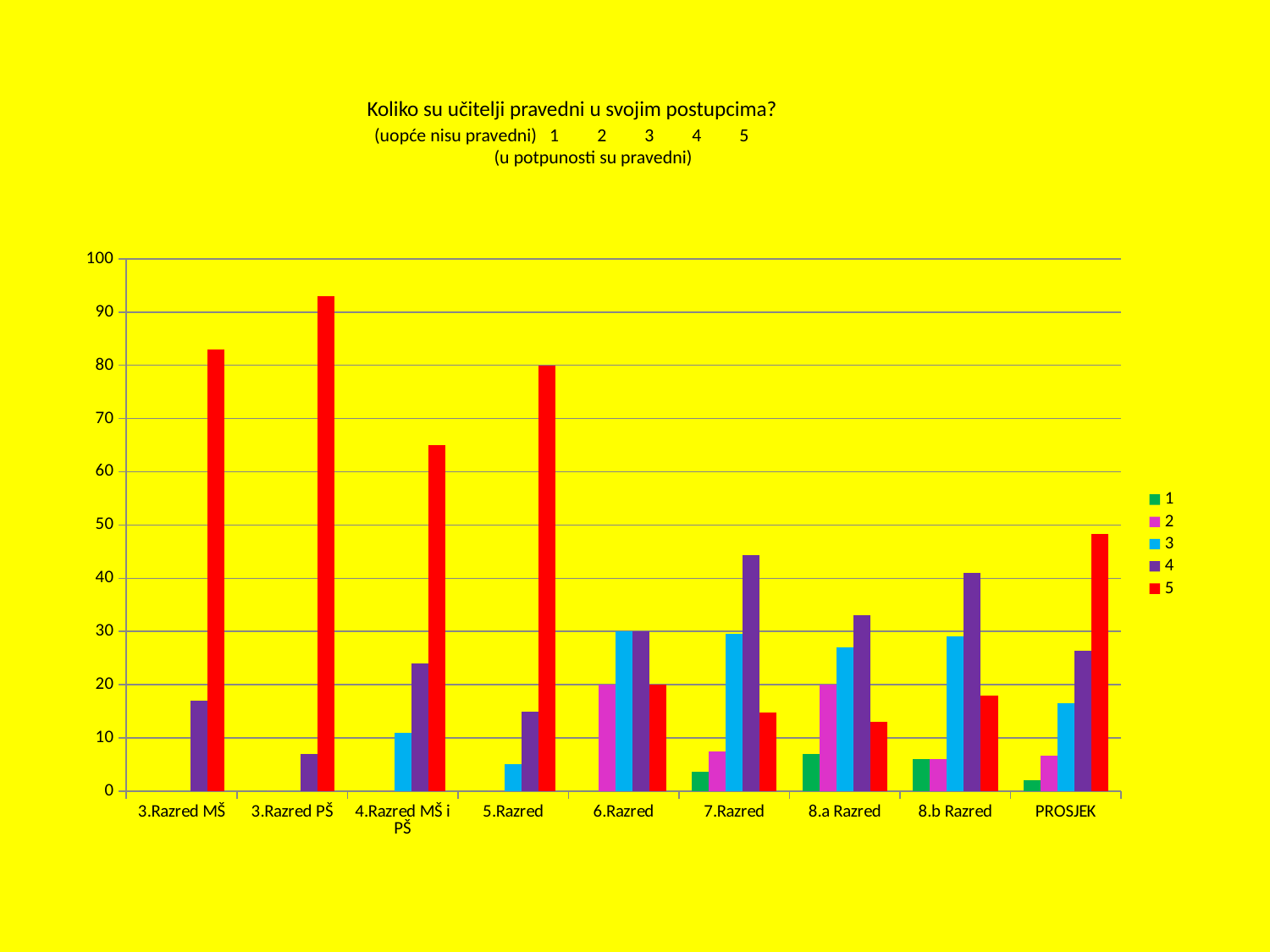
Is the value for series 5 in 4.Razred MŠ i PŠ greater or less than 60? greater Which is larger: the value for series 5 in 3.Razred MŠ or in 3.Razred PŠ? 3.Razred PŠ Which is larger: the value for series 4 in 3.Razred MŠ or in 3.Razred PŠ? 3.Razred MŠ How many series does the legend list? 5 What colour represents series 5 in the legend? red How many categories are shown along the x axis? 9 Is the value for series 5 in PROSJEK greater or less than 50? less Is the value for series 5 in 3.Razred MŠ greater or less than 80? greater What kind of chart is shown on the slide? bar chart Which category has the highest value for series 5? 3.Razred PŠ